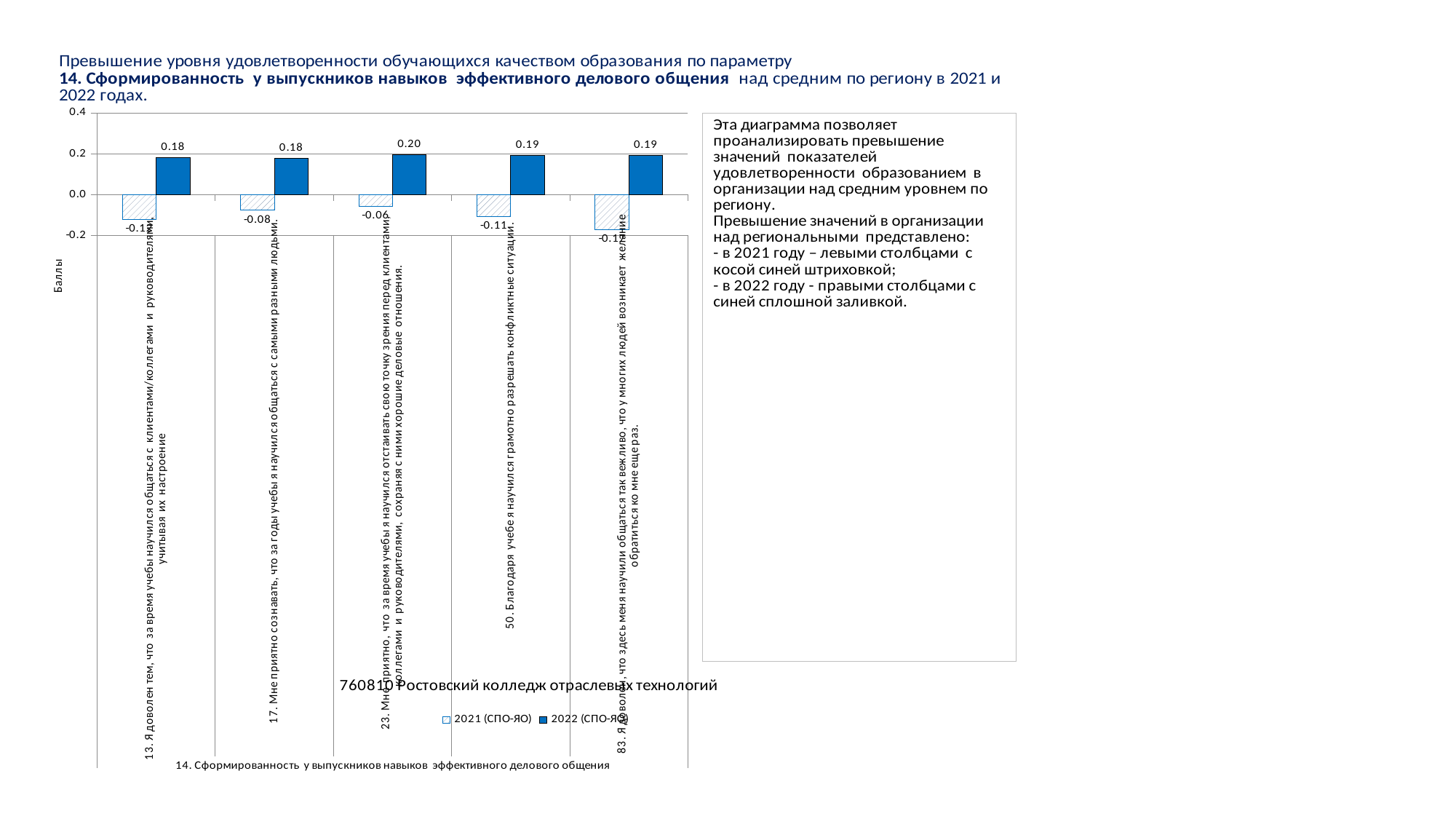
What type of chart is shown? Bar chart What is the 2022 (СПО-ЯО) value for category 17? 0.18 What is the 2022 (СПО-ЯО) value for category 23? 0.20 What is the 2021 (СПО-ЯО) value for category 50? -0.11 Is the 2021 (СПО-ЯО) value for category 13 greater or less than 0.0? less Which is larger: the 2022 value for category 23 or the 2022 value for category 50? Category 23 Which category has the highest (least negative) 2021 (СПО-ЯО) value? 23 Which category has the highest 2022 (СПО-ЯО) value? 23 How many categories are shown on the chart? 5 How many series does the legend list? 2 What is the 2021 (СПО-ЯО) value for category 23? -0.06 What is the difference between the 2022 and 2021 values for category 50? 0.30